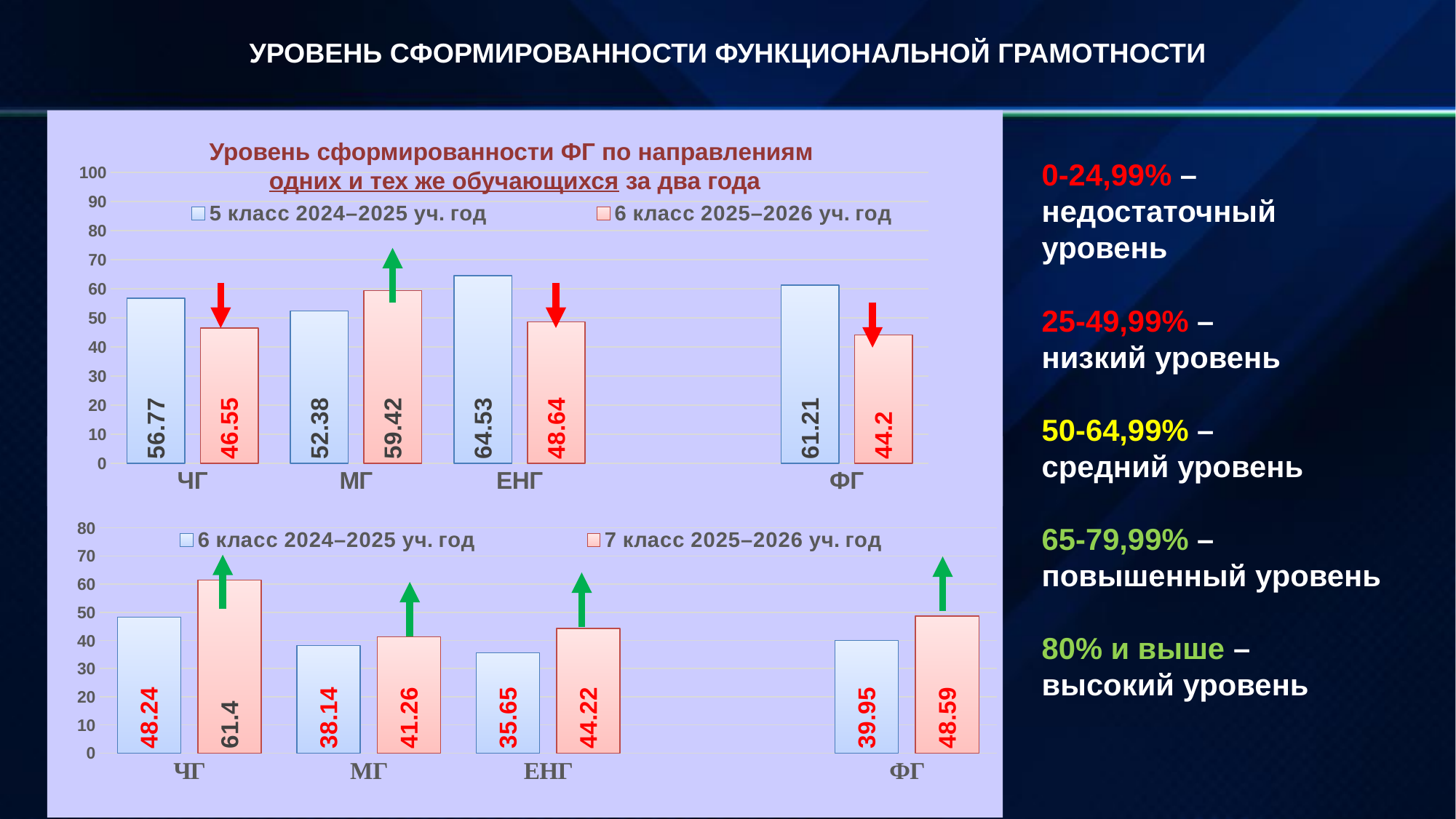
In the bottom chart, which category has the lowest value in the series '6 класс 2024–2025 уч. год'? ЕНГ In the top chart, what is the value for ЕНГ in the series '5 класс 2024–2025 уч. год'? 64.53 In the bottom chart, what is the difference between the '7 класс 2025–2026 уч. год' and '6 класс 2024–2025 уч. год' values for ФГ? 8.64 In the top chart, which category has the highest value in the series '6 класс 2025–2026 уч. год'? МГ What type of chart is the bottom chart? Bar chart In the top chart, what is the difference between the '5 класс 2024–2025 уч. год' and '6 класс 2025–2026 уч. год' values for ЧГ? 10.22 In the bottom chart, what is the value for ЧГ in the series '7 класс 2025–2026 уч. год'? 61.4 How many categories are shown on the x axis of the bottom chart? 4 In the top chart, which is larger for МГ: the '5 класс 2024–2025 уч. год' value or the '6 класс 2025–2026 уч. год' value? 6 класс 2025–2026 уч. год What is the title of the top chart? Уровень сформированности ФГ по направлениям одних и тех же обучающихся за два года How many series does the legend of the top chart list? 2 In the top chart, what is the value for ФГ in the series '6 класс 2025–2026 уч. год'? 44.2